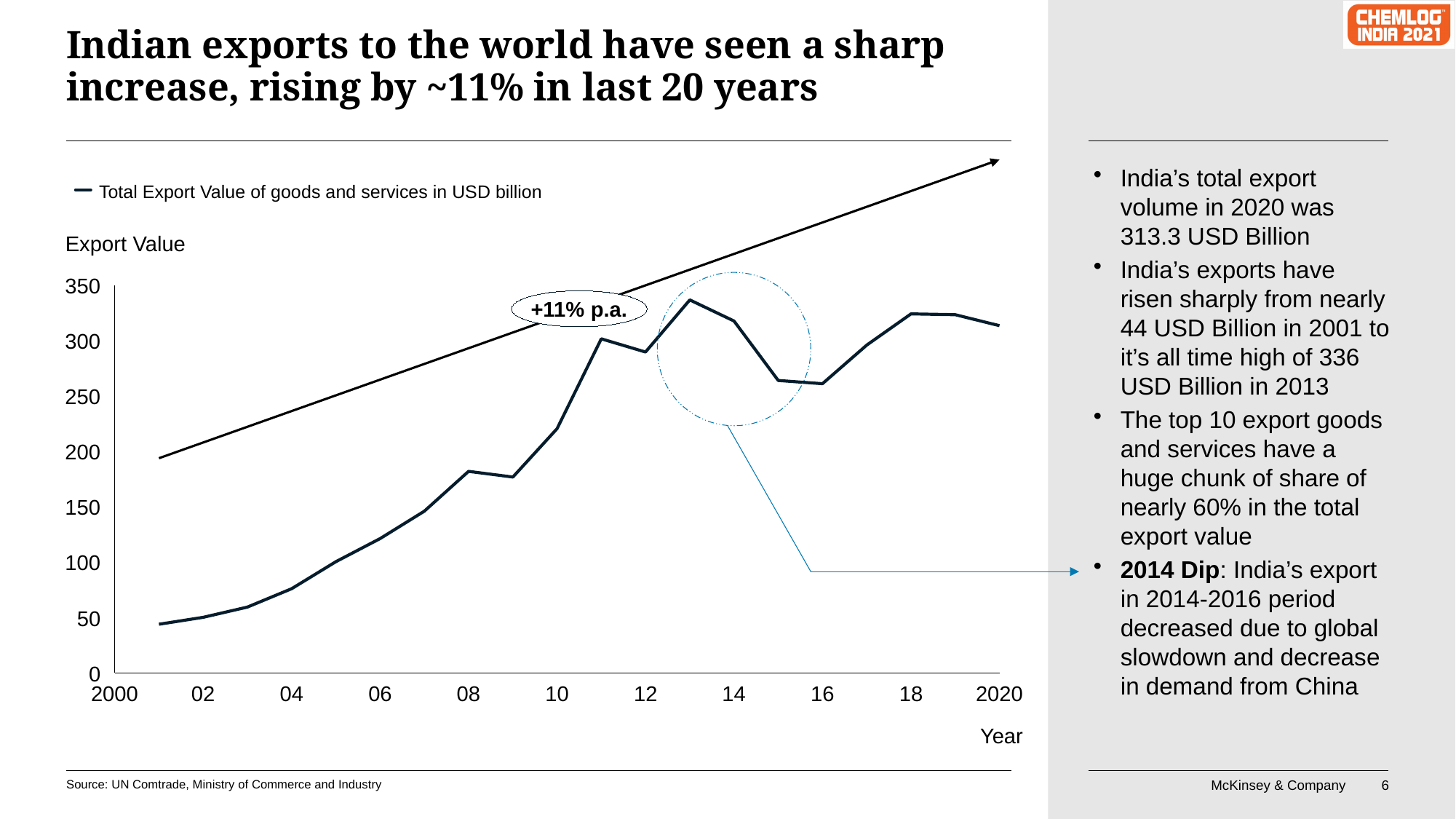
Overall, does the export value rise or fall from 2001 to 2020? rise What growth rate is written in the oval annotation next to the trend arrow? +11% p.a. In which year does the export value line reach its highest point? 2013 What kind of chart is shown on the slide? line chart Is the export value for 2008 greater or less than 150? greater How many series does the legend list? 1 Is the export value for 2001 greater or less than 100? less In which year is the export value lowest? 2001 Is the export value for 2013 greater or less than 300? greater What is the legend entry for the plotted series? Total Export Value of goods and services in USD billion Which year has the larger export value, 2013 or 2015? 2013